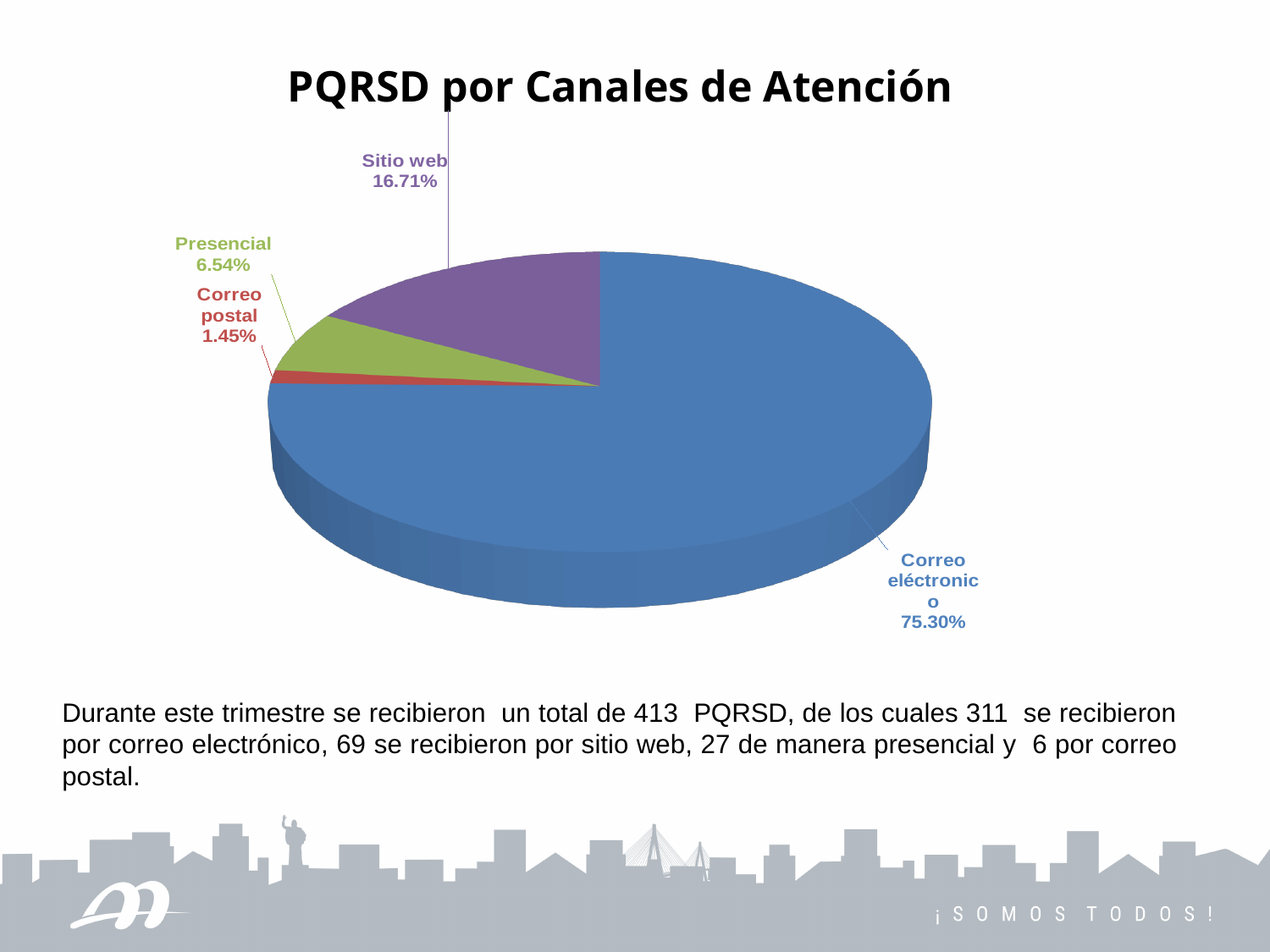
What colour is the Correo eléctronico slice? blue Which channel has the largest slice of the pie? Correo eléctronico How many slices does the pie chart have? 4 What share of the pie does Correo eléctronico represent? 75.30% What is the title of the chart? PQRSD por Canales de Atención Which is larger, the share for Sitio web or the share for Presencial? Sitio web What kind of chart is shown on the slide? pie chart What is the value shown for Presencial? 6.54% What is the difference in percentage points between Correo eléctronico and Sitio web? 58.59 Which channel has the smallest slice of the pie? Correo postal What is the value shown for Correo postal? 1.45% What share of the pie does Sitio web represent? 16.71%